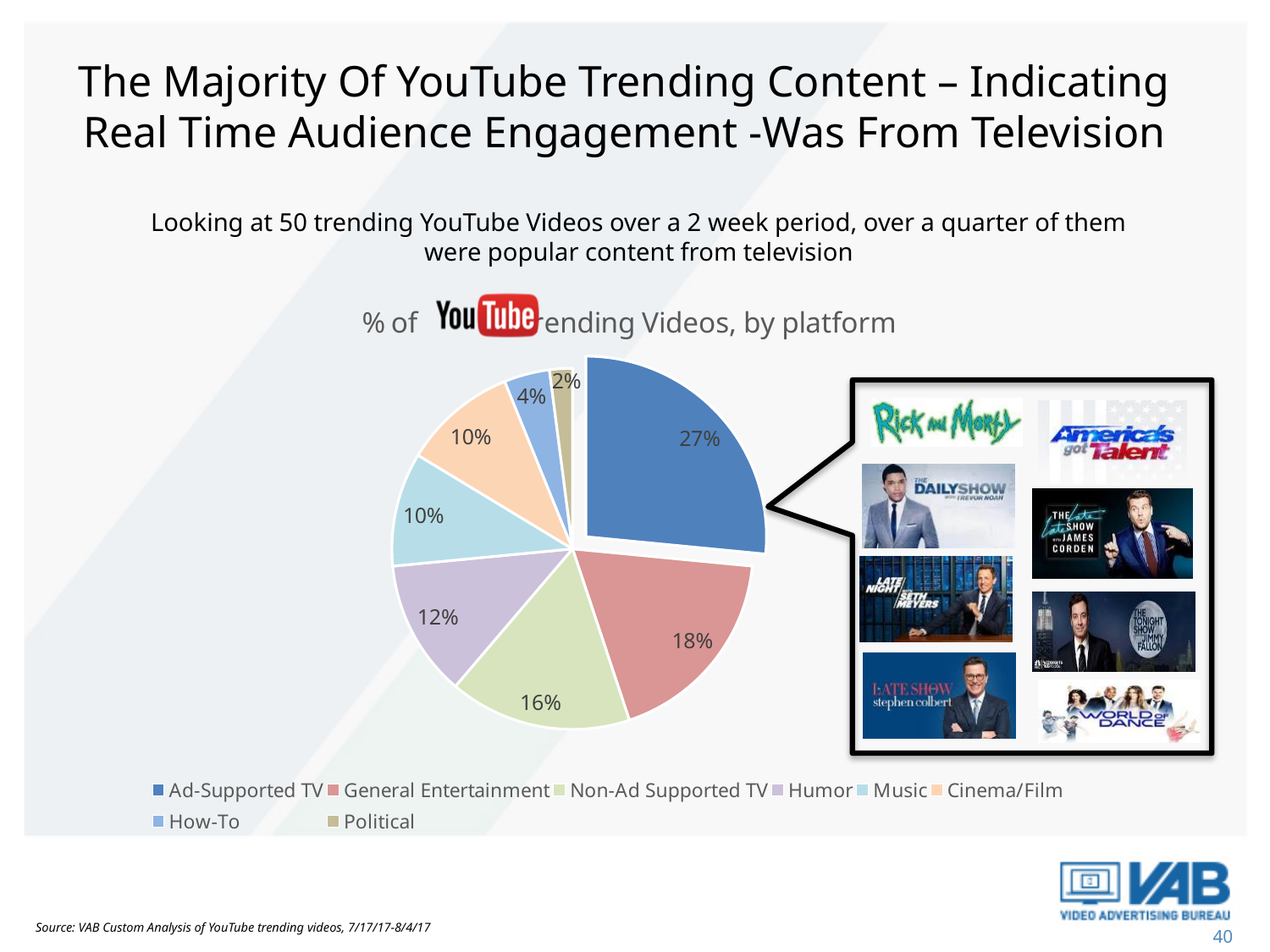
What is the difference in percentage points between Ad-Supported TV and General Entertainment? 9 percentage points Which category has the smallest share of the pie? Political What percentage of YouTube trending videos came from Ad-Supported TV? 27% What percentage is shown for Political? 2% What share of the pie is General Entertainment? 18% What percentage of trending videos is Non-Ad Supported TV? 16% What is the value for Humor? 12% What type of chart is shown on the slide? Pie chart Which is larger, the share for Humor or the share for How-To? Humor How many categories does the legend list? 8 What is the combined share of Ad-Supported TV and Non-Ad Supported TV? 43% Which category has the largest share of the pie? Ad-Supported TV